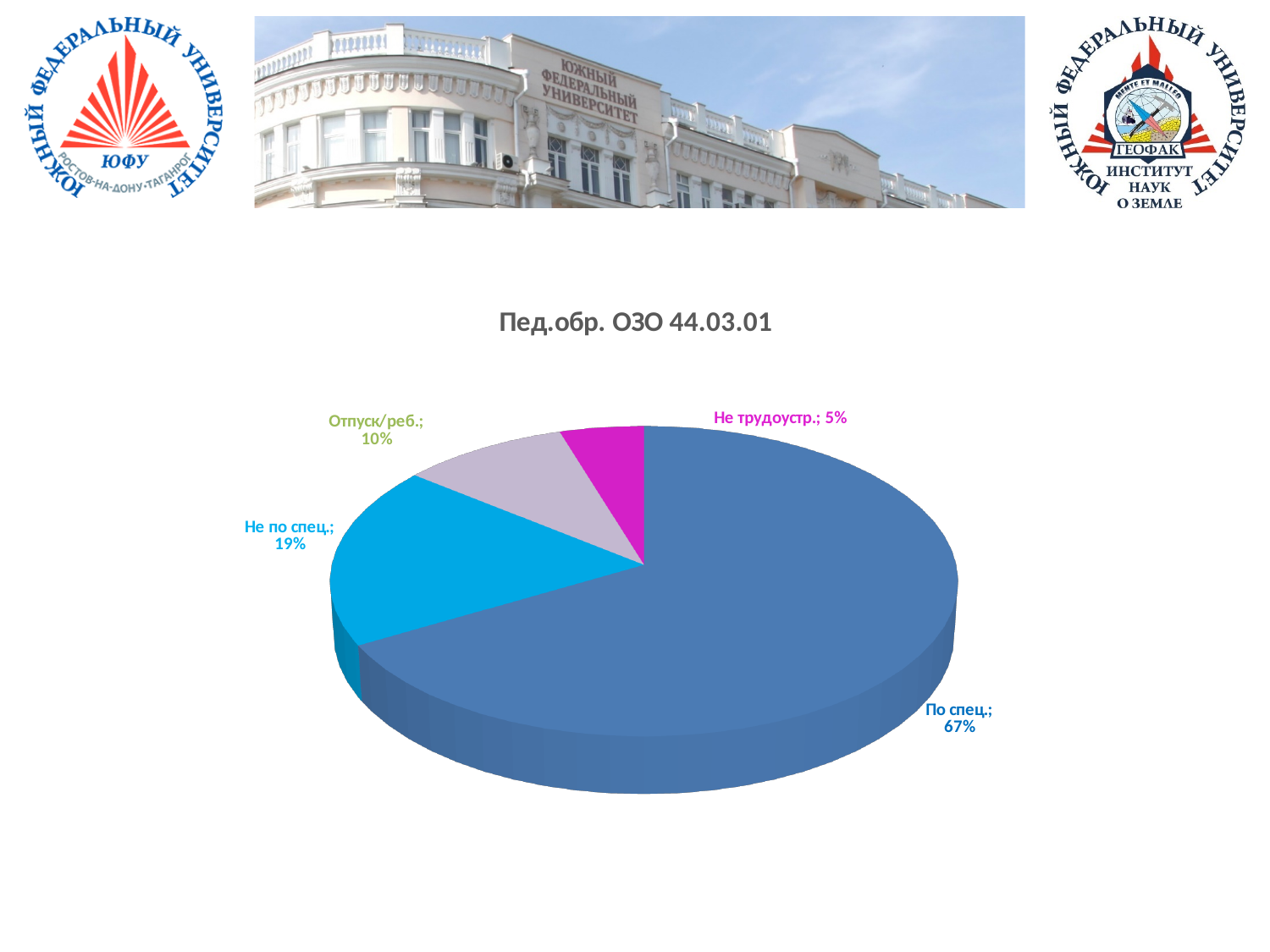
What share of the pie does "По спец." take? 67% What is the value for "Не трудоустр."? 5% Which category has the smallest slice? Не трудоустр. How many slices does the pie chart have? 4 What is the value for "Не по спец."? 19% Which is larger, the share for "Отпуск/реб." or the share for "Не трудоустр."? Отпуск/реб. What colour is the "Не трудоустр." slice? magenta What kind of chart is shown on the slide? pie chart What is the difference between the shares of "По спец." and "Не по спец."? 48% What is the value for "Отпуск/реб."? 10% Which category has the largest slice? По спец. What is the title of the chart? Пед.обр. ОЗО 44.03.01